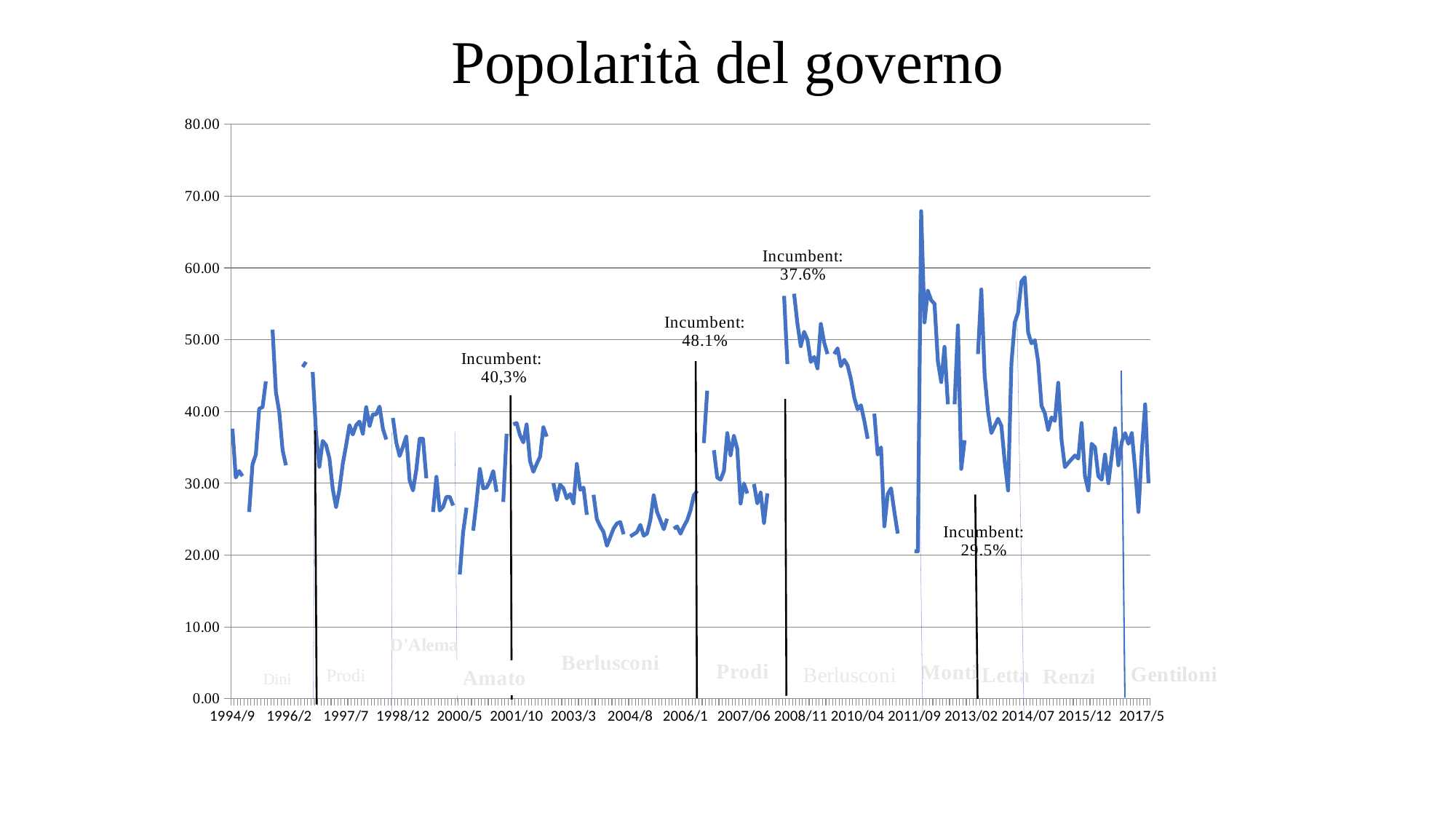
What incumbent percentage is annotated near the 2008/11 boundary on the chart? 37.6% What incumbent percentage is annotated near the 2006/1 boundary on the chart? 48.1% Is the peak value of the line around 2011/09 greater or less than 60? greater What kind of chart is shown on the slide? line chart What is the title of the chart? Popolarità del governo Is the lowest value of the line around 2000/5 greater or less than 20? less What incumbent percentage is annotated near the 2013/02 boundary on the chart? 29.5% How many 'Incumbent' annotations are shown on the chart? 4 What is the last date label on the horizontal axis? 2017/5 What incumbent percentage is annotated near the 2001/10 boundary on the chart? 40,3% Are the values of the line around 2004/8 greater or less than 30? less What is the highest value shown on the vertical axis? 80.00